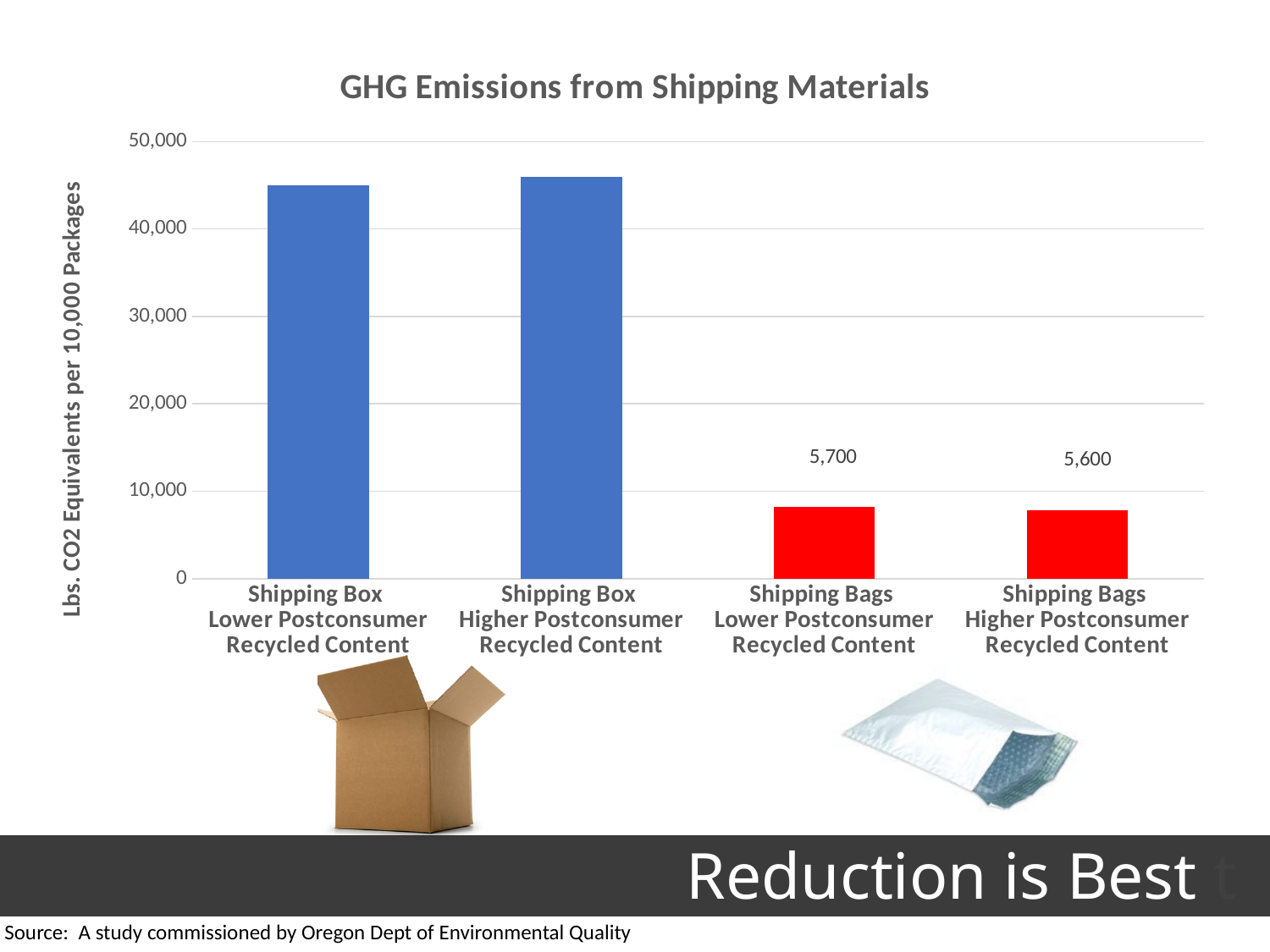
Which is larger: the value for Shipping Box Lower Postconsumer Recycled Content or Shipping Bags Lower Postconsumer Recycled Content? Shipping Box Lower Postconsumer Recycled Content Is the value for Shipping Box Higher Postconsumer Recycled Content greater or less than 50,000? less What is the value for Shipping Bags Lower Postconsumer Recycled Content? 5,700 How many categories are shown in the chart? 4 What kind of chart is shown on the slide? bar chart What is the difference between the values for Shipping Bags Lower Postconsumer Recycled Content and Shipping Bags Higher Postconsumer Recycled Content? 100 Is the value for Shipping Box Lower Postconsumer Recycled Content greater or less than 40,000? greater What is the title of the chart? GHG Emissions from Shipping Materials What is the label on the vertical axis of the chart? Lbs. CO2 Equivalents per 10,000 Packages Which category has the lowest GHG emissions? Shipping Bags Higher Postconsumer Recycled Content What is the value for Shipping Bags Higher Postconsumer Recycled Content? 5,600 Which is larger: the value for Shipping Bags Lower Postconsumer Recycled Content or Shipping Bags Higher Postconsumer Recycled Content? Shipping Bags Lower Postconsumer Recycled Content